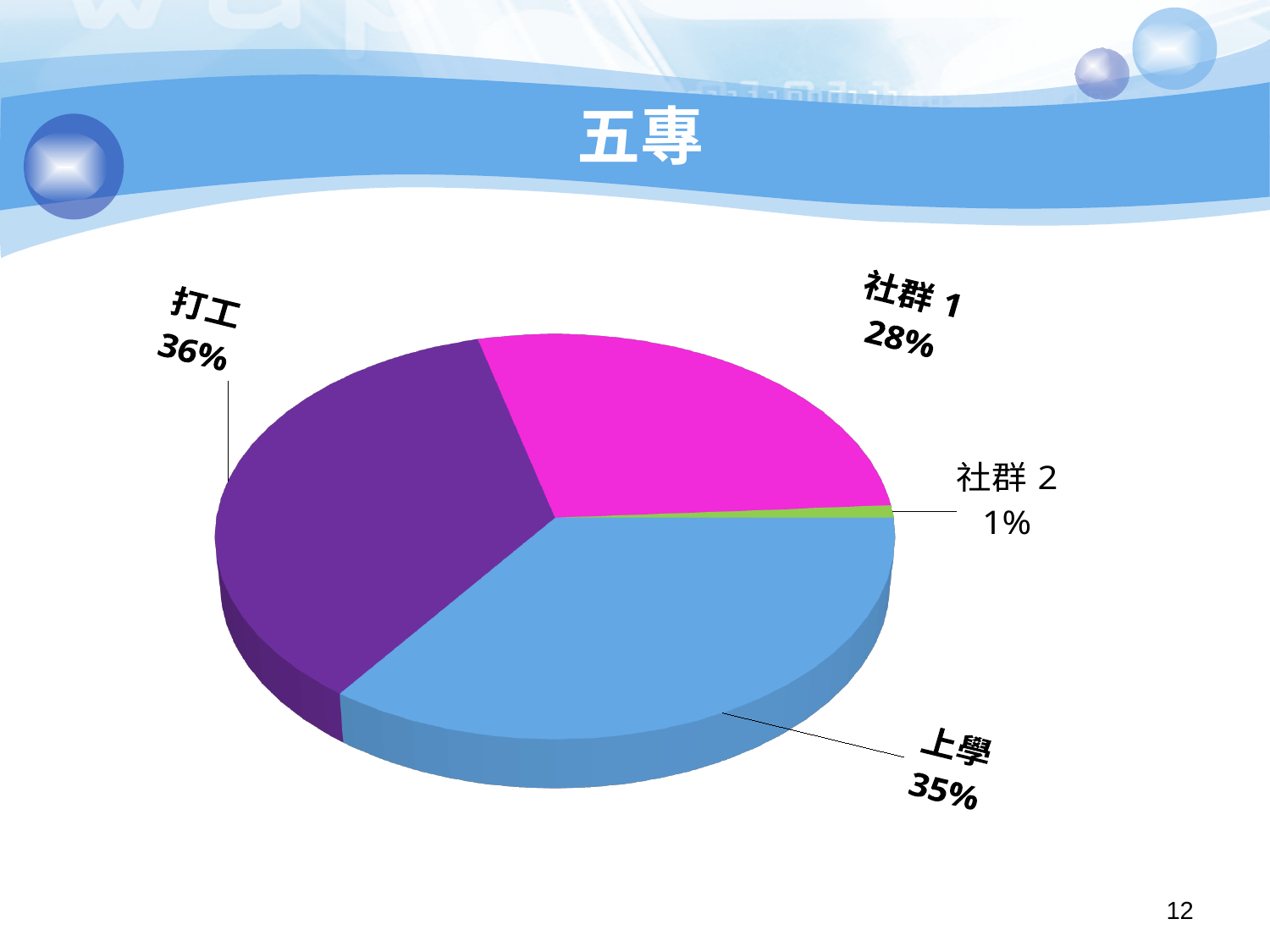
How many slices does the pie chart have? 4 What kind of chart is shown on the slide? Pie chart Which category has the smallest slice of the pie? 社群 2 What is the difference in percentage points between 上學 and 社群 2? 34 Which is larger, the share for 社群 1 or the share for 上學? 上學 What share of the pie does 上學 have? 35% What share of the pie does 社群 1 have? 28% What share of the pie does 社群 2 have? 1% What share of the pie does 打工 have? 36% What is the title of the slide containing the chart? 五專 What is the difference in percentage points between 打工 and 社群 1? 8 Which category has the largest slice of the pie? 打工